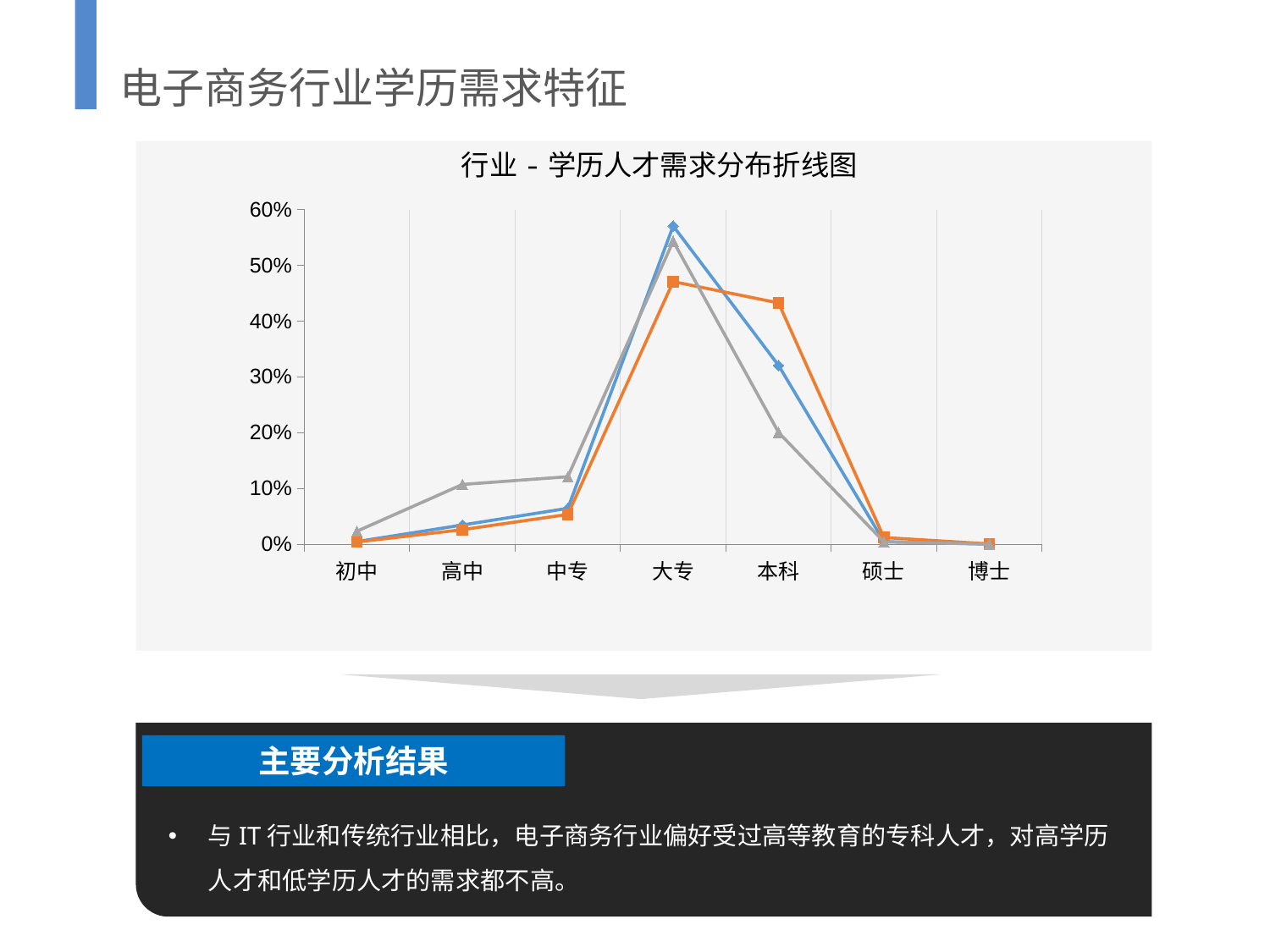
How many education-level categories are shown on the x axis of the chart? 7 Is the value of the blue line at 本科 greater or less than 40%? less What kind of chart is shown on the slide? Line chart Do the values of the blue line rise or fall from 大专 to 博士? Fall Which category has the lowest value for the gray line? 博士 Is the value of the orange line at 本科 greater or less than 40%? greater Which category has the highest value for the orange line? 大专 How many lines are plotted in the chart? 3 At 本科, which line has the larger value, the orange line or the gray line? Orange line Is the value of the gray line at 大专 greater or less than 50%? greater Which category has the highest value for the blue line? 大专 What is the title of the chart? 行业 - 学历人才需求分布折线图